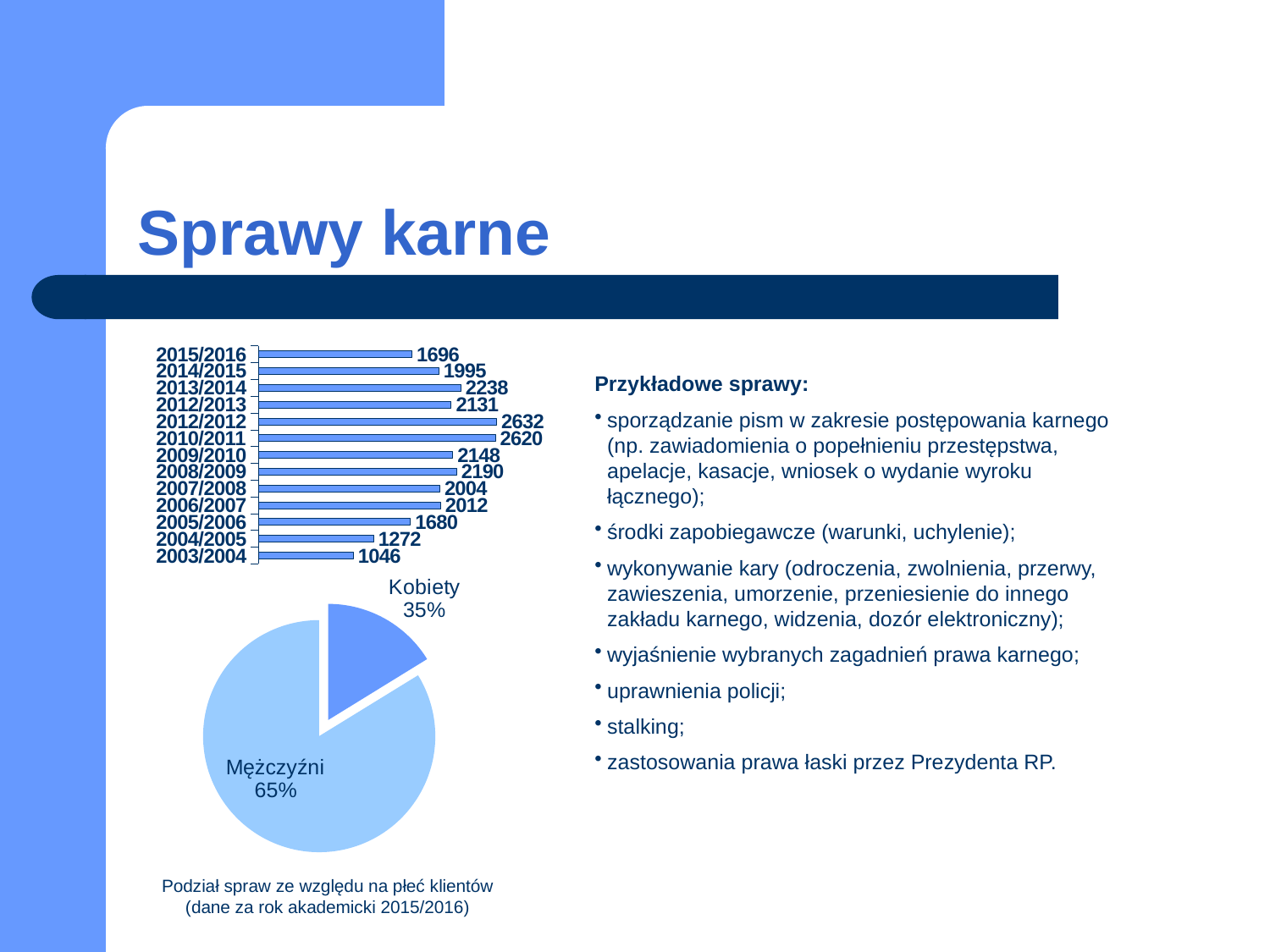
In the bar chart at the top left of the slide, what is the value for 2010/2011? 2620 In the pie chart at the bottom left of the slide, what share is labelled Kobiety? 35% In the bar chart at the top left of the slide, which category has the lowest value? 2003/2004 In the bar chart at the top left of the slide, what is the value for 2003/2004? 1046 In the bar chart at the top left of the slide, which category has the highest value? 2012/2012 In the bar chart at the top left of the slide, which is larger, the value for 2014/2015 or the value for 2005/2006? 2014/2015 In the bar chart at the top left of the slide, what is the value for 2015/2016? 1696 In the pie chart at the bottom left of the slide, what share is labelled Mężczyźni? 65% In the bar chart at the top left of the slide, what is the difference between the values for 2013/2014 and 2012/2013? 107 How many slices does the pie chart at the bottom left of the slide have? 2 How many categories are shown in the bar chart at the top left of the slide? 13 What kind of chart is the chart at the top left of the slide? bar chart